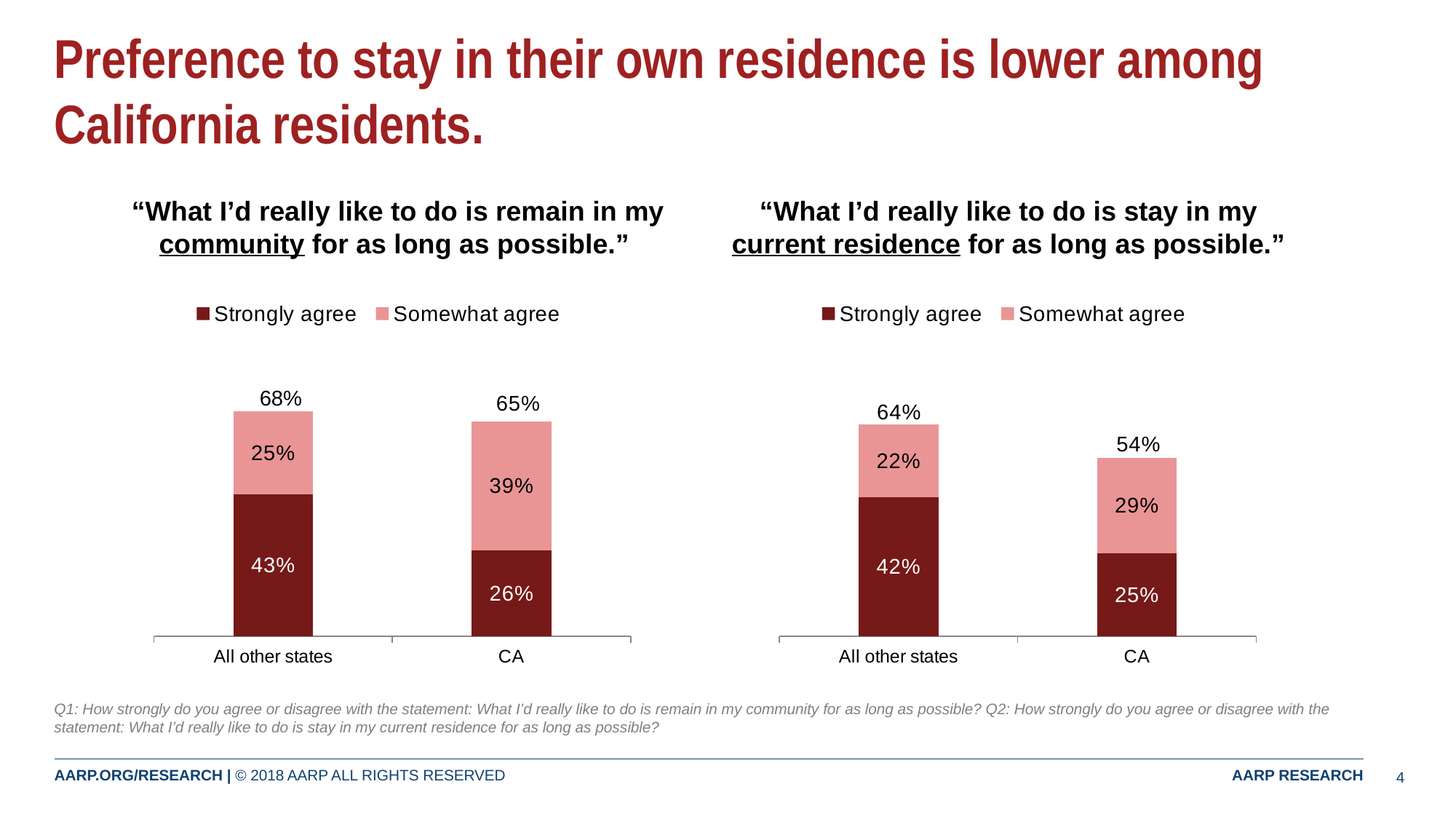
How many categories are shown on the x axis of the right chart? 2 In the right chart ("stay in my current residence"), what is the total of the stacked bar for All other states? 64% How many series does the legend of the left chart list? 2 In the left chart ("remain in my community"), which category has the higher Strongly agree value, All other states or CA? All other states In the left chart ("remain in my community"), what is the total of the stacked bar for CA? 65% In the left chart ("remain in my community"), what is the Somewhat agree value for CA? 39% In the left chart ("remain in my community"), what is the Strongly agree value for All other states? 43% In the right chart ("stay in my current residence"), what is the difference between the Strongly agree values for All other states and CA? 17% In the right chart ("stay in my current residence"), which category has the lower stacked-bar total? CA In the right chart ("stay in my current residence"), what is the Strongly agree value for CA? 25% In the right chart ("stay in my current residence"), what is the Somewhat agree value for All other states? 22% What kind of chart is the left chart ("remain in my community")? Stacked bar chart